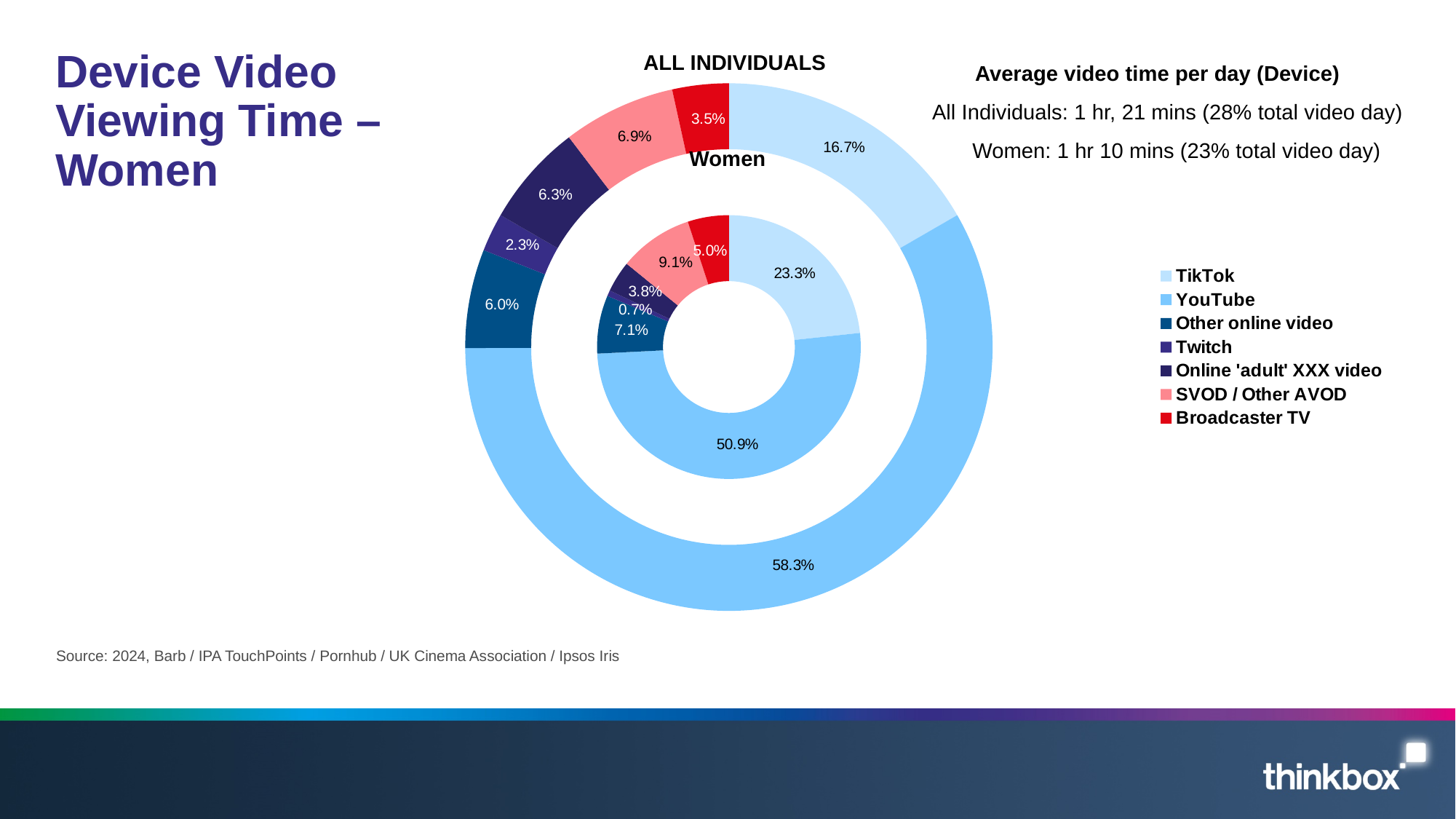
What is the SVOD / Other AVOD share for All Individuals (outer ring)? 6.9% Which category has the smallest share in the All Individuals ring? Twitch How many categories does the legend list? 7 Which ring of the doughnut chart represents Women, the inner or the outer? Inner What kind of chart is shown on the slide? Doughnut chart What is the YouTube share for All Individuals (outer ring)? 58.3% What is the difference between the TikTok share for Women (23.3%) and for All Individuals (16.7%)? 6.6% What is the TikTok share for Women (inner ring)? 23.3% What is the Twitch share for Women (inner ring)? 0.7% Is the Broadcaster TV share larger for Women or for All Individuals? Women Which category has the largest share in the Women ring? YouTube What is the difference between the YouTube share for All Individuals (58.3%) and for Women (50.9%)? 7.4%